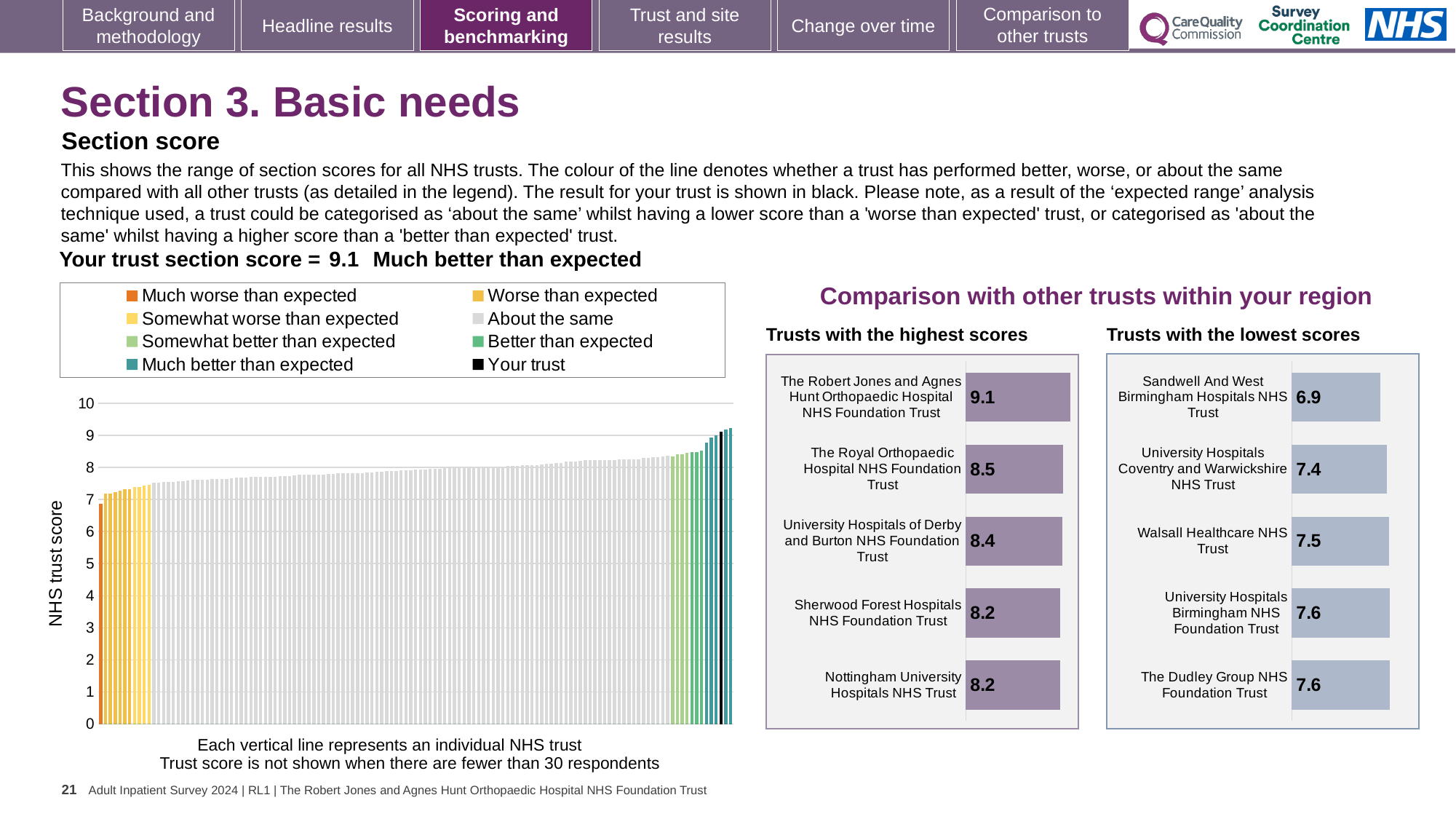
How many trusts are shown in the 'Trusts with the highest scores' chart? 5 In the 'Trusts with the lowest scores' chart, which has the larger score: University Hospitals Coventry and Warwickshire NHS Trust or Walsall Healthcare NHS Trust? Walsall Healthcare NHS Trust In the main chart of NHS trust scores on the left, what is the section score for your trust (the black bar)? 9.1 In the 'Trusts with the highest scores' chart, which trust has the highest score? The Robert Jones and Agnes Hunt Orthopaedic Hospital NHS Foundation Trust In the 'Trusts with the highest scores' chart, what is the difference between the scores of The Robert Jones and Agnes Hunt Orthopaedic Hospital NHS Foundation Trust and University Hospitals of Derby and Burton NHS Foundation Trust? 0.7 In the main chart of NHS trust scores on the left, is the value of the lowest bar (the orange one) greater or less than 8? less What type of chart is the 'Trusts with the lowest scores' chart? Bar chart In the 'Trusts with the lowest scores' chart, which trust has the lowest score? Sandwell And West Birmingham Hospitals NHS Trust How many entries does the legend of the main chart on the left list? 8 In the 'Trusts with the lowest scores' chart, what is the score for Walsall Healthcare NHS Trust? 7.5 In the 'Trusts with the highest scores' chart, what is the score for The Royal Orthopaedic Hospital NHS Foundation Trust? 8.5 In the 'Trusts with the lowest scores' chart, what is the difference between the scores of The Dudley Group NHS Foundation Trust and Sandwell And West Birmingham Hospitals NHS Trust? 0.7